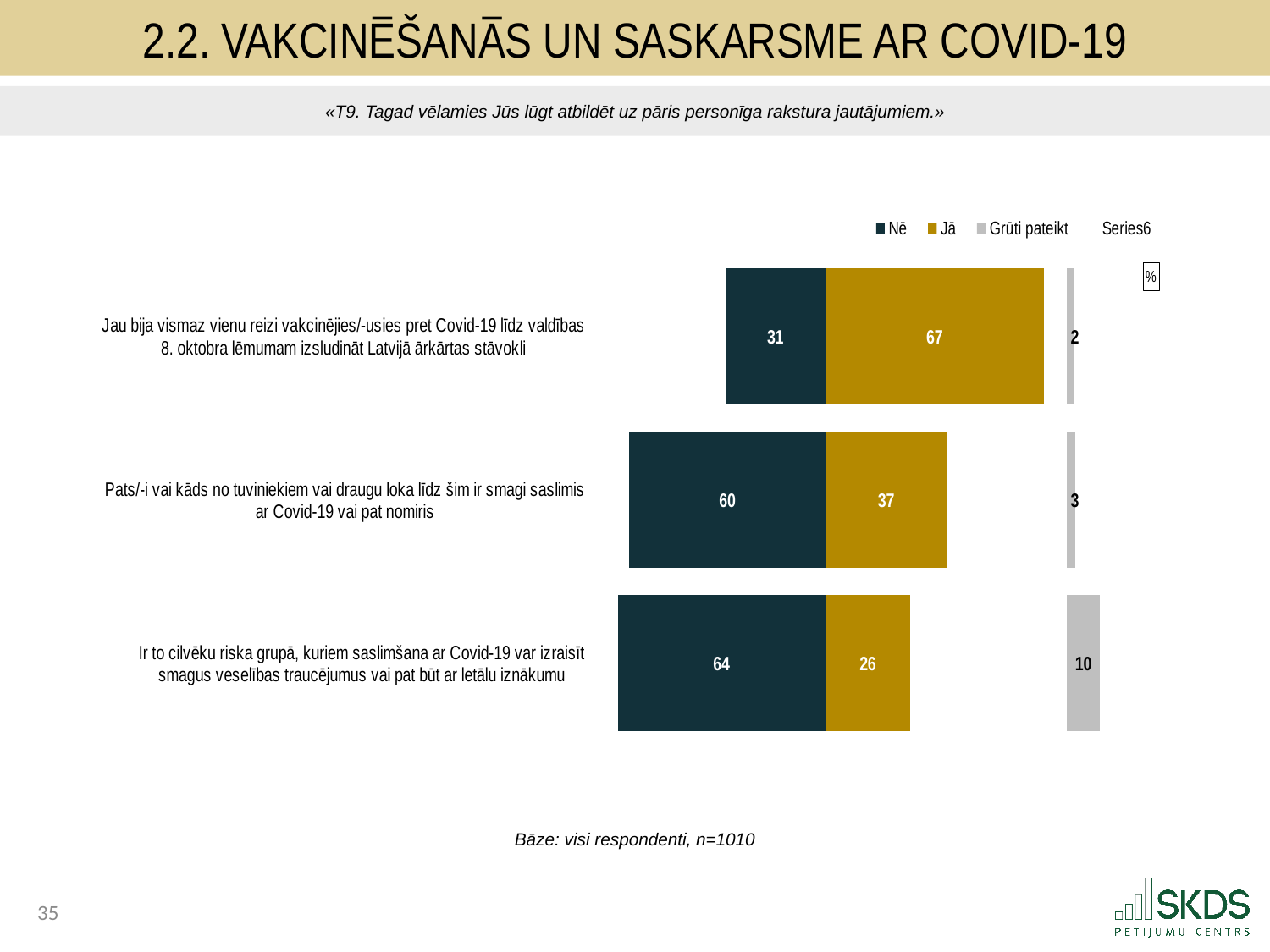
What is the "Grūti pateikt" value for "Ir to cilvēku riska grupā, kuriem saslimšana ar Covid-19 var izraisīt smagus veselības traucējumus vai pat būt ar letālu iznākumu"? 10 Which statement has the highest "Nē" value? Ir to cilvēku riska grupā, kuriem saslimšana ar Covid-19 var izraisīt smagus veselības traucējumus vai pat būt ar letālu iznākumu What percentage answered "Jā" for "Jau bija vismaz vienu reizi vakcinējies/-usies pret Covid-19 līdz valdības 8. oktobra lēmumam izsludināt Latvijā ārkārtas stāvokli"? 67 How many statements (categories) are shown in the chart? 3 Which statement has the lowest "Jā" value? Ir to cilvēku riska grupā, kuriem saslimšana ar Covid-19 var izraisīt smagus veselības traucējumus vai pat būt ar letālu iznākumu What is the total of the "Nē", "Jā" and "Grūti pateikt" values for the statement about being in the Covid-19 risk group? 100 For the statement about being vaccinated at least once before the 8 October decision, which is larger: the "Nē" value or the "Jā" value? Jā What is the difference between the "Nē" and "Jā" values for "Pats/-i vai kāds no tuviniekiem vai draugu loka līdz šim ir smagi saslimis ar Covid-19 vai pat nomiris"? 23 How many entries does the chart legend list? 4 What type of chart is shown on the slide? Stacked bar chart What is the "Nē" value for "Pats/-i vai kāds no tuviniekiem vai draugu loka līdz šim ir smagi saslimis ar Covid-19 vai pat nomiris"? 60 What is the base (number of respondents) stated below the chart? n=1010